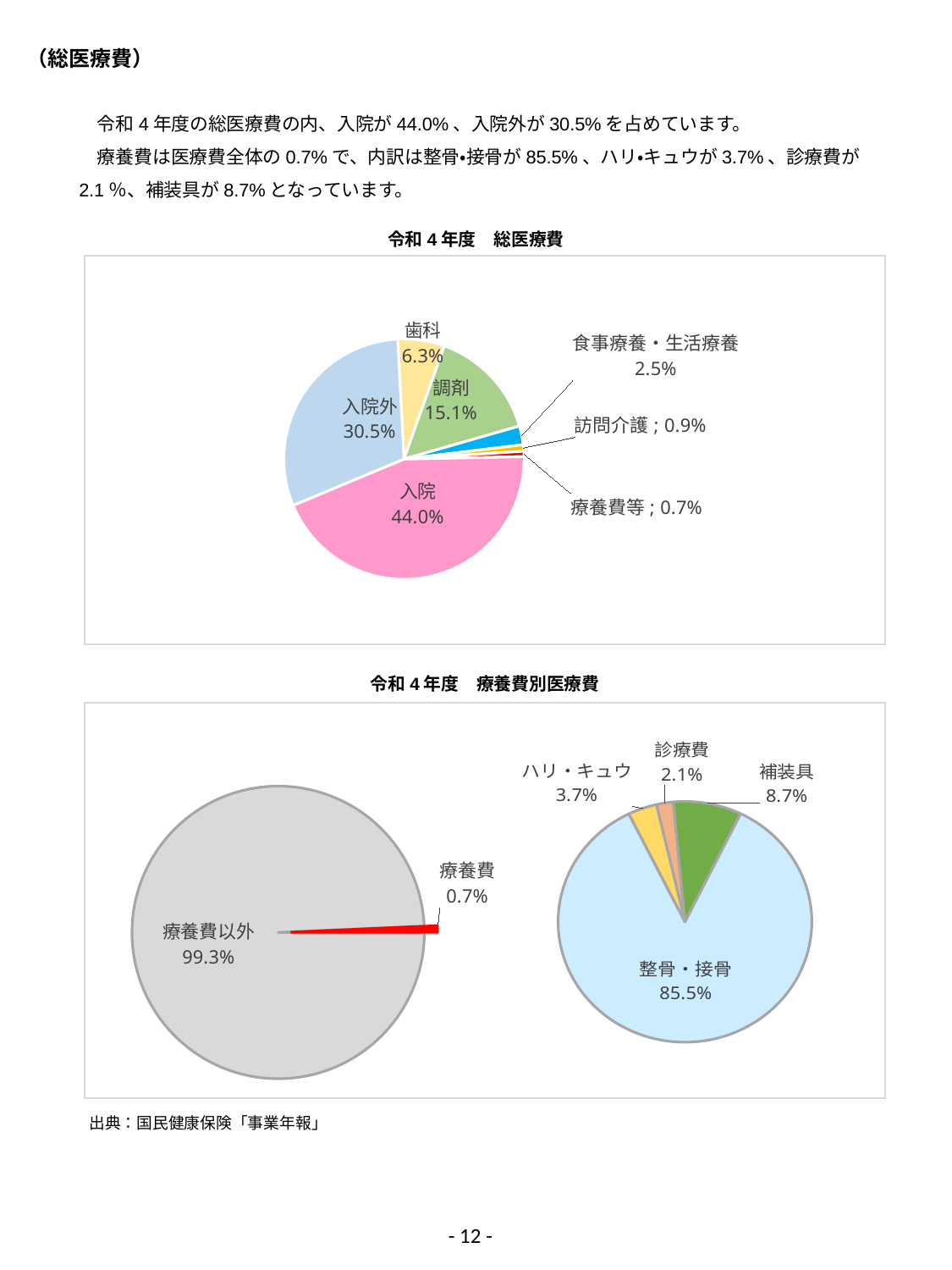
In the left pie of the 令和4年度 療養費別医療費 chart, what share does 療養費以外 account for? 99.3% In the 令和4年度 総医療費 chart, what is the value for 調剤? 15.1% In the 令和4年度 総医療費 chart, what share does 入院 account for? 44.0% In the right pie of the 令和4年度 療養費別医療費 chart, what is the difference between ハリ・キュウ and 診療費? 1.6% In the 令和4年度 総医療費 chart, which category has the smallest share? 療養費等 In the 令和4年度 総医療費 chart, what is the difference between 入院 and 入院外? 13.5% What type of chart is the 令和4年度 総医療費 chart? Pie chart In the right pie of the 令和4年度 療養費別医療費 chart, which category has the largest share? 整骨・接骨 How many categories are shown in the 令和4年度 総医療費 chart? 7 In the right pie of the 令和4年度 療養費別医療費 chart, what is the value for 補装具? 8.7% In the 令和4年度 総医療費 chart, which category has the largest share? 入院 In the 令和4年度 総医療費 chart, which is larger, 歯科 or 食事療養・生活療養? 歯科